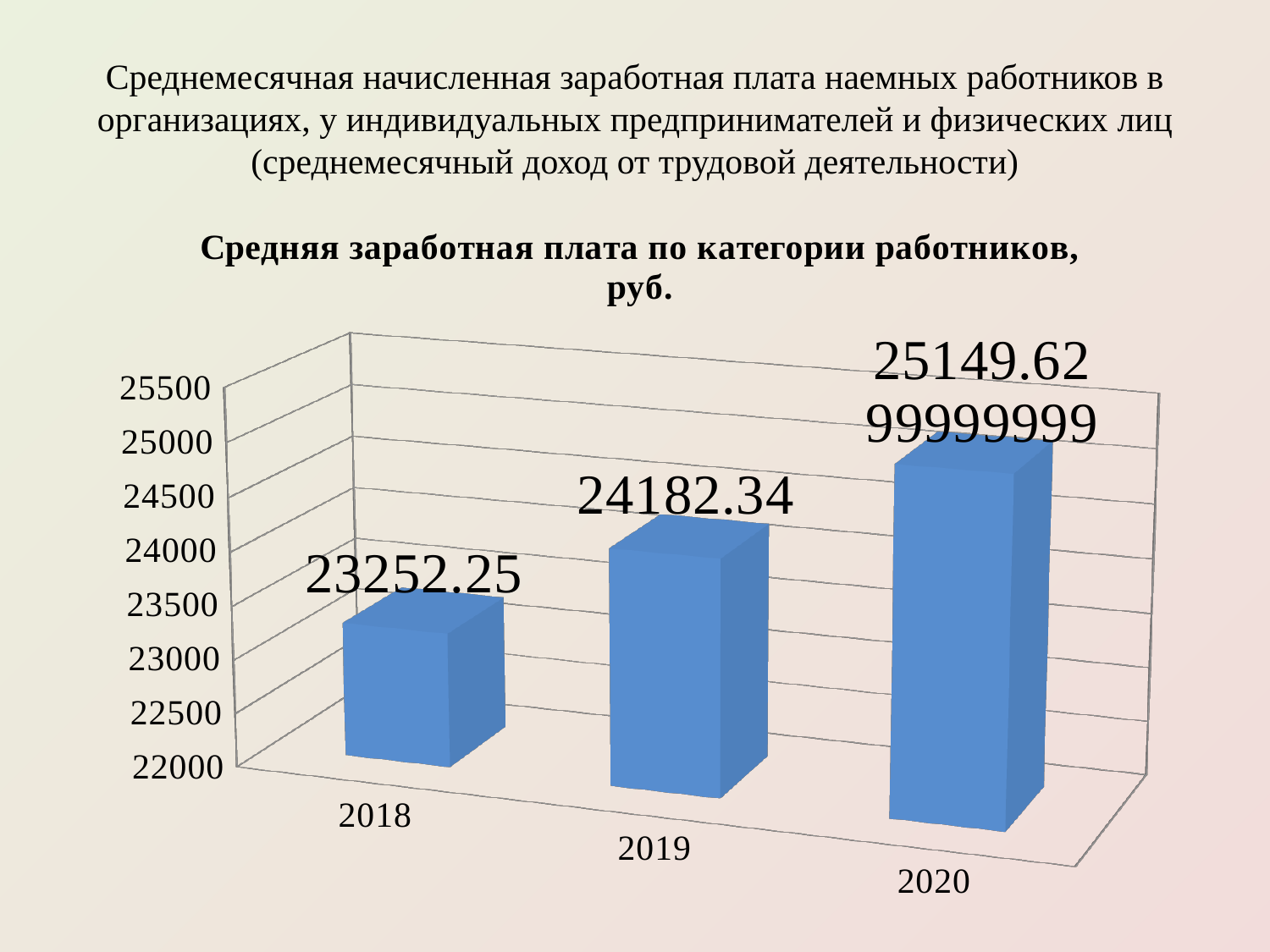
Which year has the highest value? 2020 Is the value for 2020 greater or less than 25000? greater What is the value for 2019? 24182.34 Which year has the lowest value? 2018 What is the value for 2018? 23252.25 Which is larger, the value for 2019 or the value for 2018? 2019 Do the values rise or fall from 2018 to 2020? rise Is the value for 2018 greater or less than 23500? less What is the difference between the values for 2019 and 2018? 930.09 How many years (categories) are plotted in the chart? 3 What type of chart is shown on the slide? bar chart What is the chart's title? Средняя заработная плата по категории работников, руб.